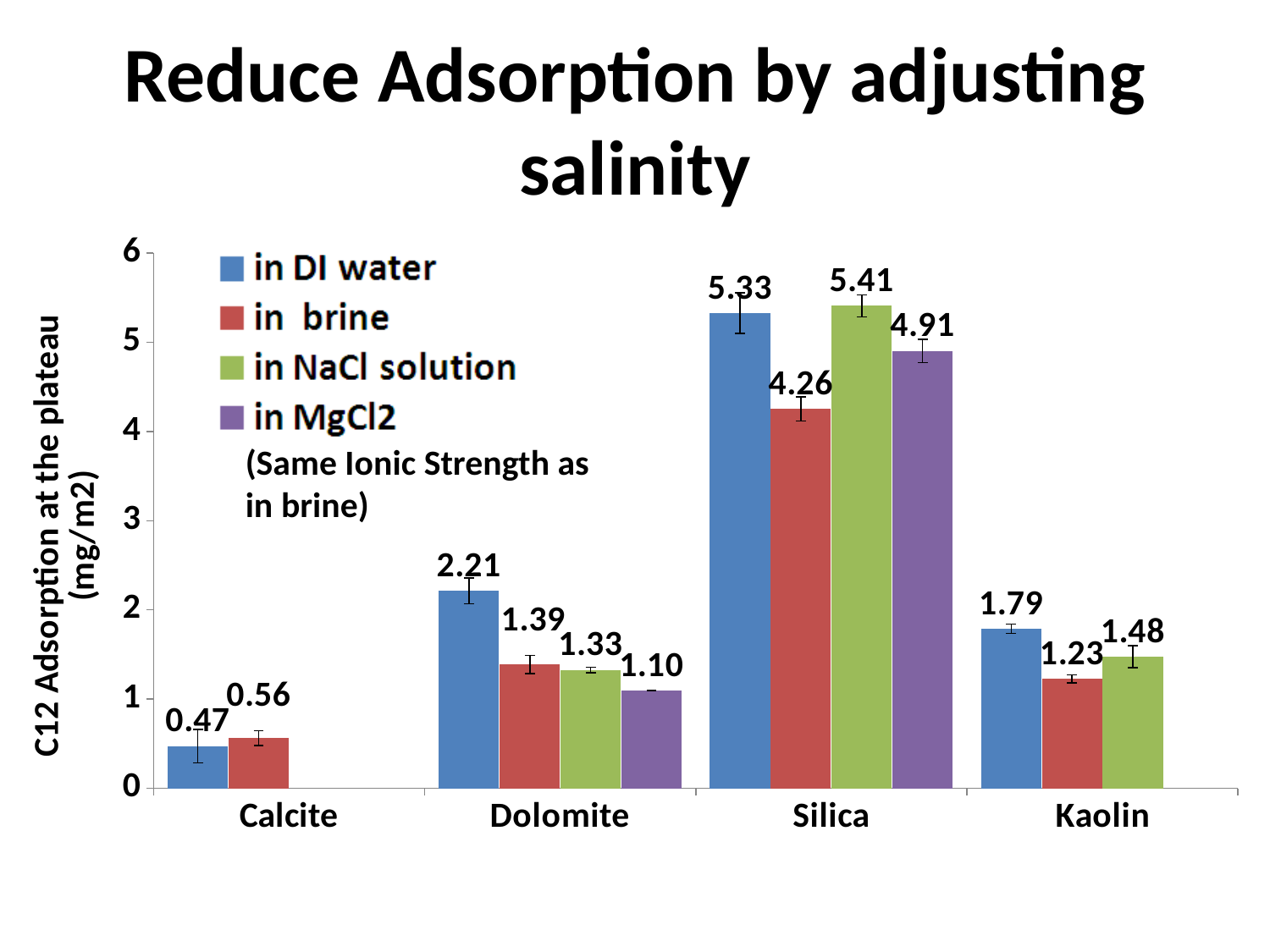
Is the value for Silica in MgCl2 greater or less than 4? greater What kind of chart is shown on the slide? Bar chart Which mineral has the lowest adsorption in DI water? Calcite How many series does the legend list? 4 What is the C12 adsorption value for Dolomite in MgCl2? 1.10 Which mineral has the highest adsorption in NaCl solution? Silica How many mineral categories are shown on the x axis? 4 What is the C12 adsorption value for Kaolin in brine? 1.23 What is the difference between the DI water and brine values for Silica? 1.07 What is the y-axis label of the chart? C12 Adsorption at the plateau (mg/m2) Which is larger for Dolomite: the value in brine or the value in NaCl solution? in brine What is the C12 adsorption value for Silica in DI water? 5.33